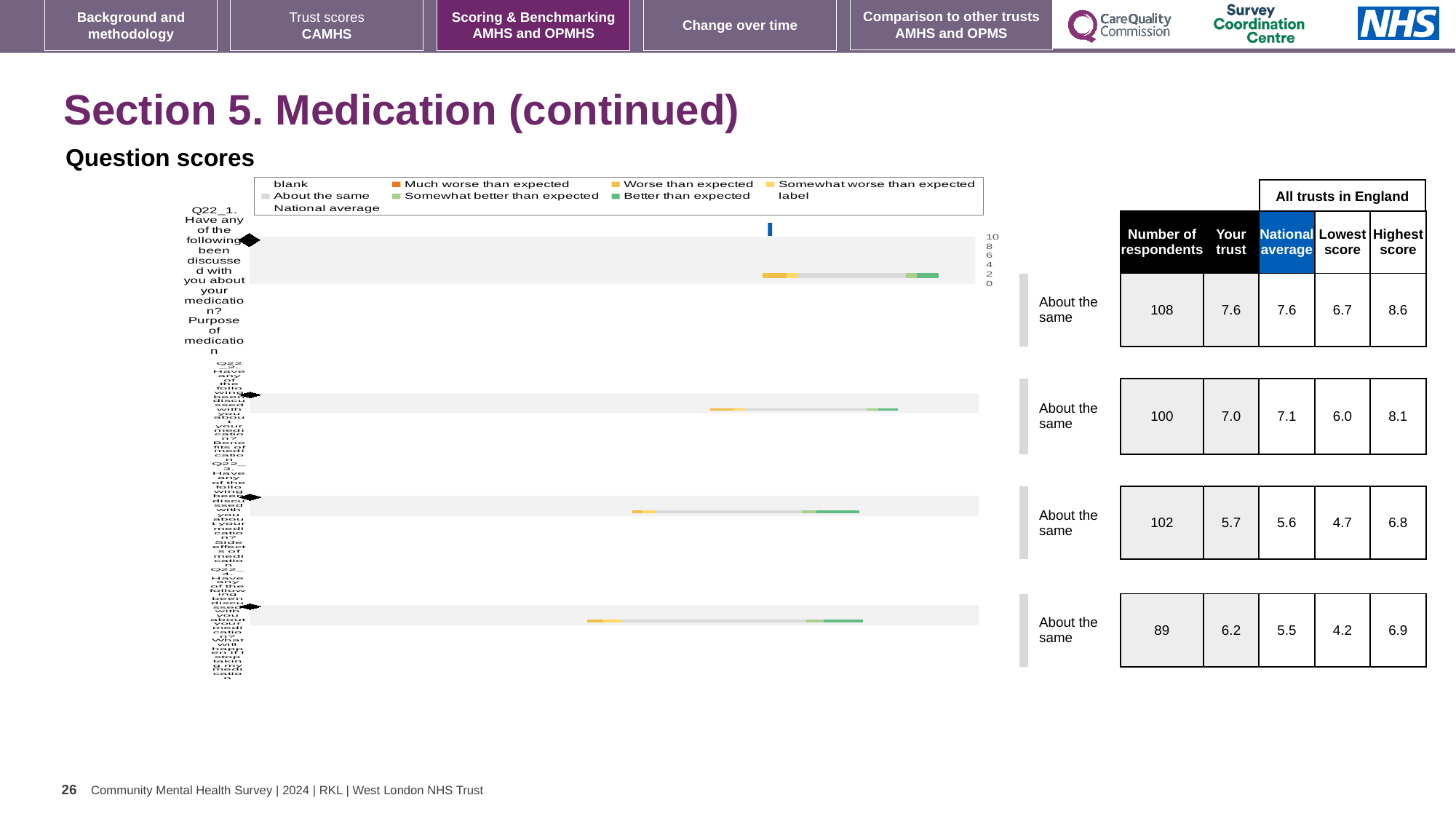
In the table beside the chart, how many respondents are listed for the first row (Q22_1)? 108 Which row has the lowest 'Your trust' score in the table beside the chart? The third row (Q22_3), 5.7 How many entries does the chart's legend list? 9 What benchmark category is shown beside each of the four bars? About the same For the fourth row (Q22_4), which is larger: the 'Your trust' score or the national average? Your trust (6.2) What is the highest value shown on the chart's axis? 10 Which row has the highest 'Your trust' score in the table beside the chart? The first row (Q22_1), 7.6 What kind of chart is shown under 'Question scores'? Bar chart How many bars (question rows) does the chart contain? 4 For the first row (Q22_1), what is the difference between the highest score (8.6) and the lowest score (6.7)? 1.9 In the table beside the chart, what is the 'Your trust' score for the first row (Q22_1, Purpose of medication)? 7.6 What colour does the legend use for 'Much worse than expected'? Orange